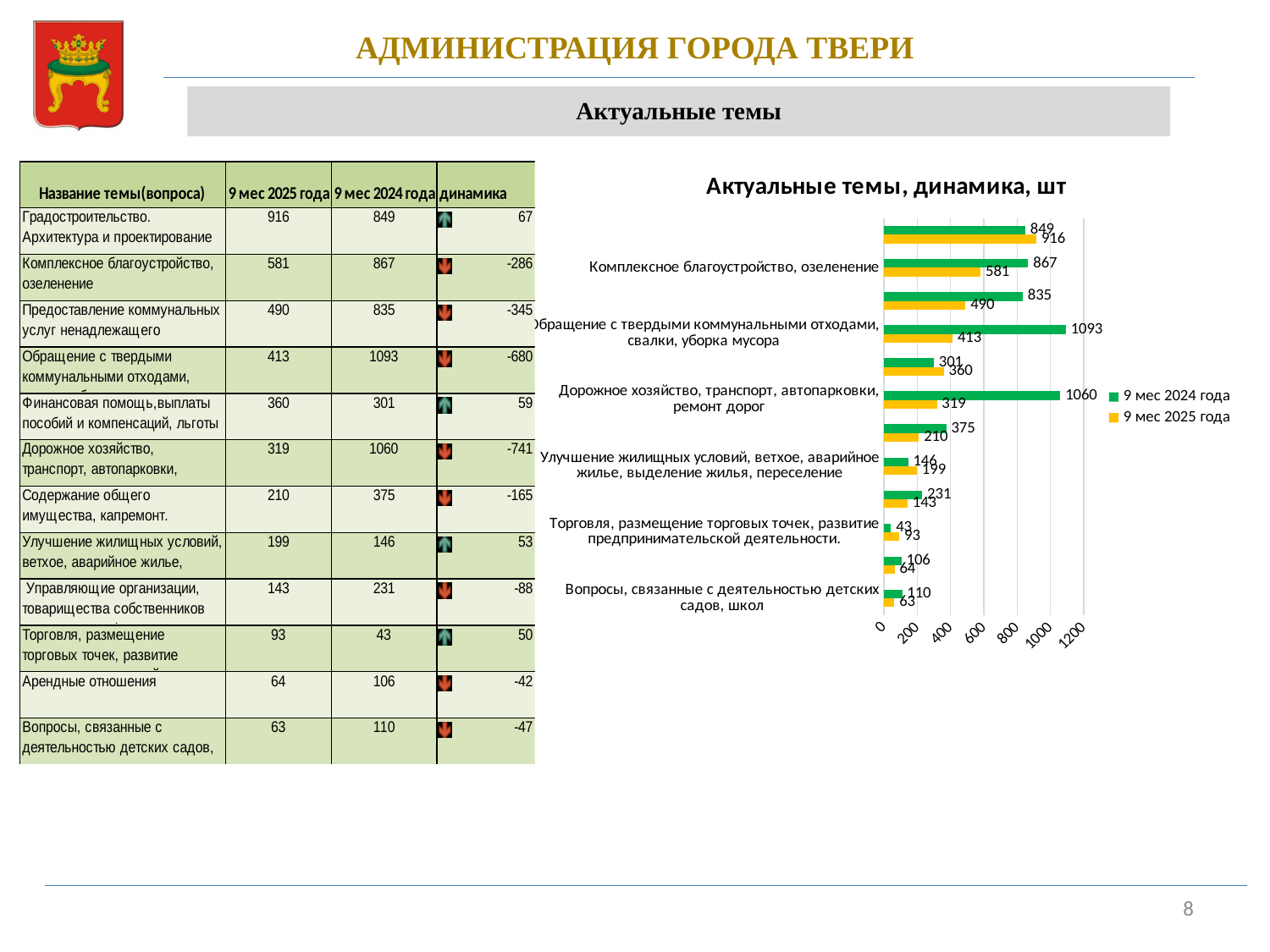
What is the value for 'Торговля, размещение торговых точек, развитие предпринимательской деятельности.' in the '9 мес 2025 года' series? 93 Which category has the highest value in the '9 мес 2024 года' series? Обращение с твердыми коммунальными отходами, свалки, уборка мусора What is the value for 'Дорожное хозяйство, транспорт, автопарковки, ремонт дорог' in the '9 мес 2025 года' series? 319 For 'Улучшение жилищных условий, ветхое, аварийное жилье, выделение жилья, переселение', which series has the larger value: '9 мес 2024 года' or '9 мес 2025 года'? 9 мес 2025 года What type of chart is shown on the slide? bar chart What is the value for 'Комплексное благоустройство, озеленение' in the '9 мес 2024 года' series? 867 What is the value for 'Комплексное благоустройство, озеленение' in the '9 мес 2025 года' series? 581 How many series does the chart legend list? 2 What is the value for 'Вопросы, связанные с деятельностью детских садов, школ' in the '9 мес 2024 года' series? 110 What is the value for 'Обращение с твердыми коммунальными отходами, свалки, уборка мусора' in the '9 мес 2024 года' series? 1093 What is the difference between the '9 мес 2024 года' and '9 мес 2025 года' values for 'Дорожное хозяйство, транспорт, автопарковки, ремонт дорог'? 741 What is the title of the chart? Актуальные темы, динамика, шт